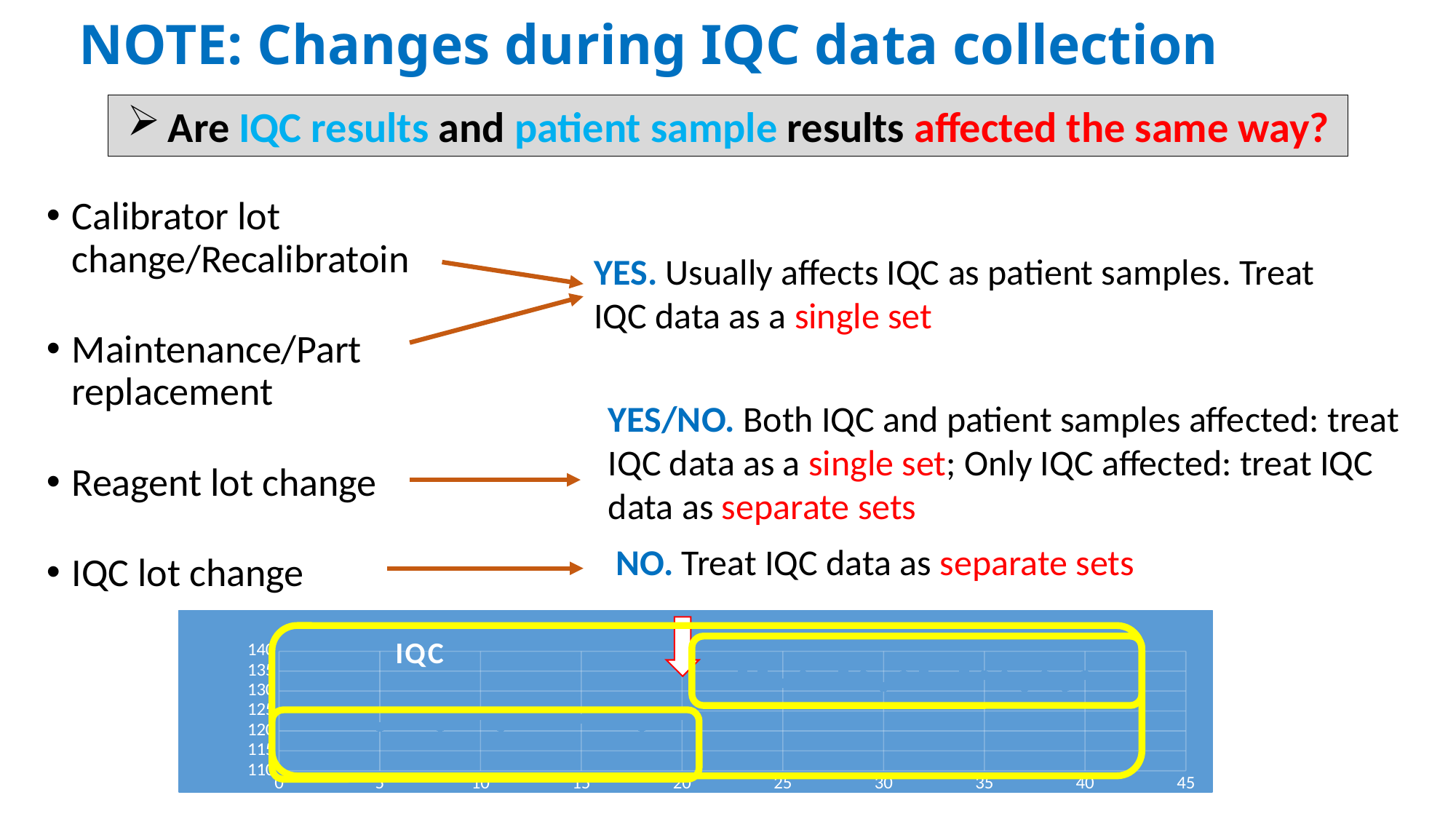
On the IQC chart, which group of points is higher: those before x = 20 or those after x = 20? those after x = 20 On the IQC chart, are the data points plotted for x values between 0 and 20 greater or less than 130? less What is the lowest value labelled on the y axis of the IQC chart? 110 What is the title shown on the chart at the bottom of the slide? IQC What is the highest value labelled on the y axis of the IQC chart? 140 What is the largest value labelled on the x axis of the IQC chart? 45 On the IQC chart, are the data points plotted for x values between 25 and 40 greater or less than 125? greater What is the spacing between consecutive tick labels on the x axis of the IQC chart? 5 How many yellow-outlined groups of data points are highlighted on the IQC chart? 2 On the IQC chart, do the plotted values shift up or down after the point marked by the arrow near x = 20? up